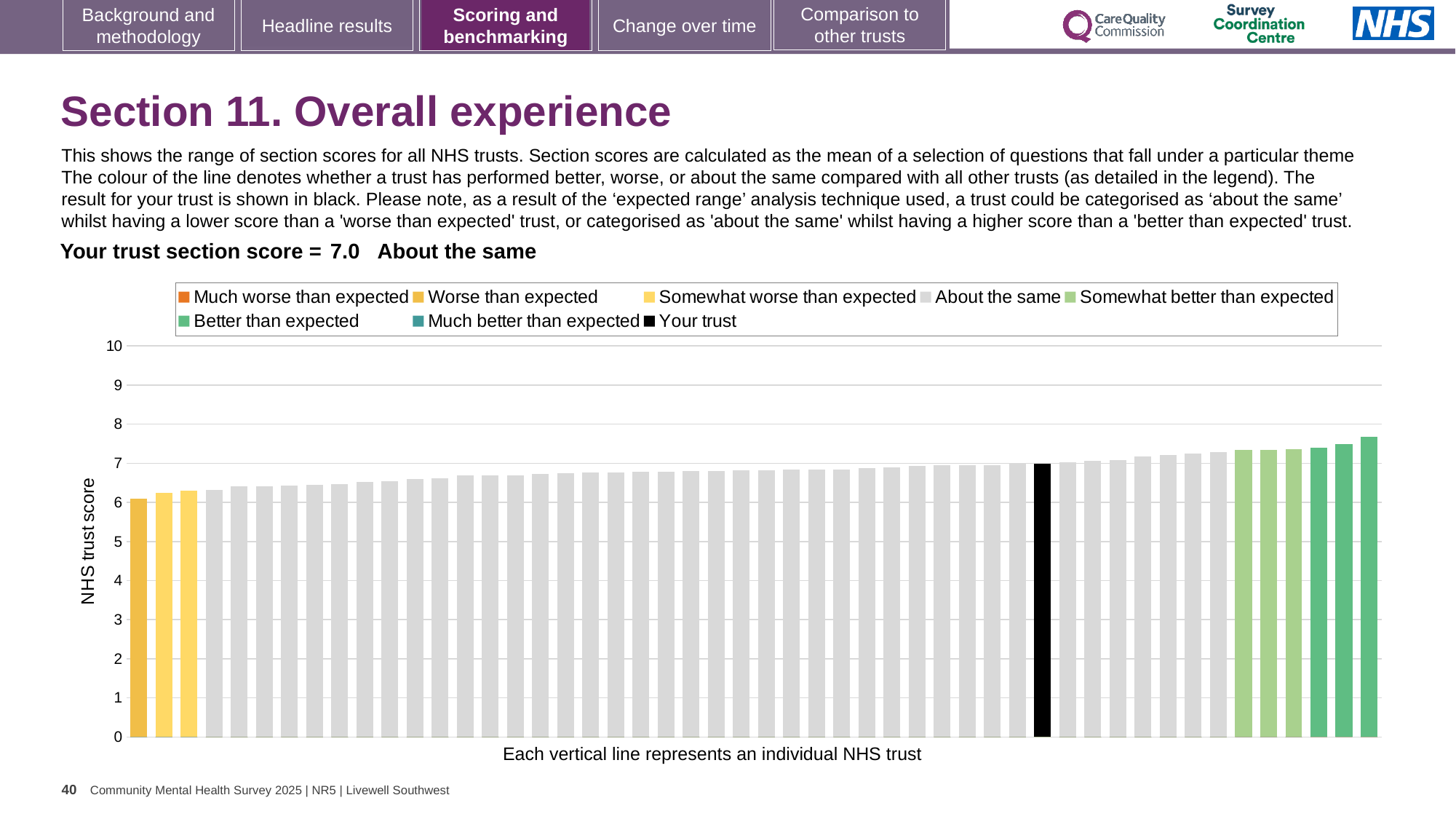
Is the value of the leftmost bar greater or less than 5? greater Is the value of the tallest bar greater or less than 8? less What colour is the bar representing your trust? black How many entries does the chart legend list? 8 Which is larger, the value for your trust (black bar) or the value of the leftmost bar? your trust What is the title of the vertical axis? NHS trust score Which legend category do the tallest bars on the right of the chart belong to? Better than expected Is the value for your trust (the black bar) greater or less than 5? greater What is the section score for your trust shown on the slide? 7.0 Which category is your trust placed in according to the slide? About the same What kind of chart is shown on the slide? bar chart Do the bar values rise or fall from left to right along the x axis? rise